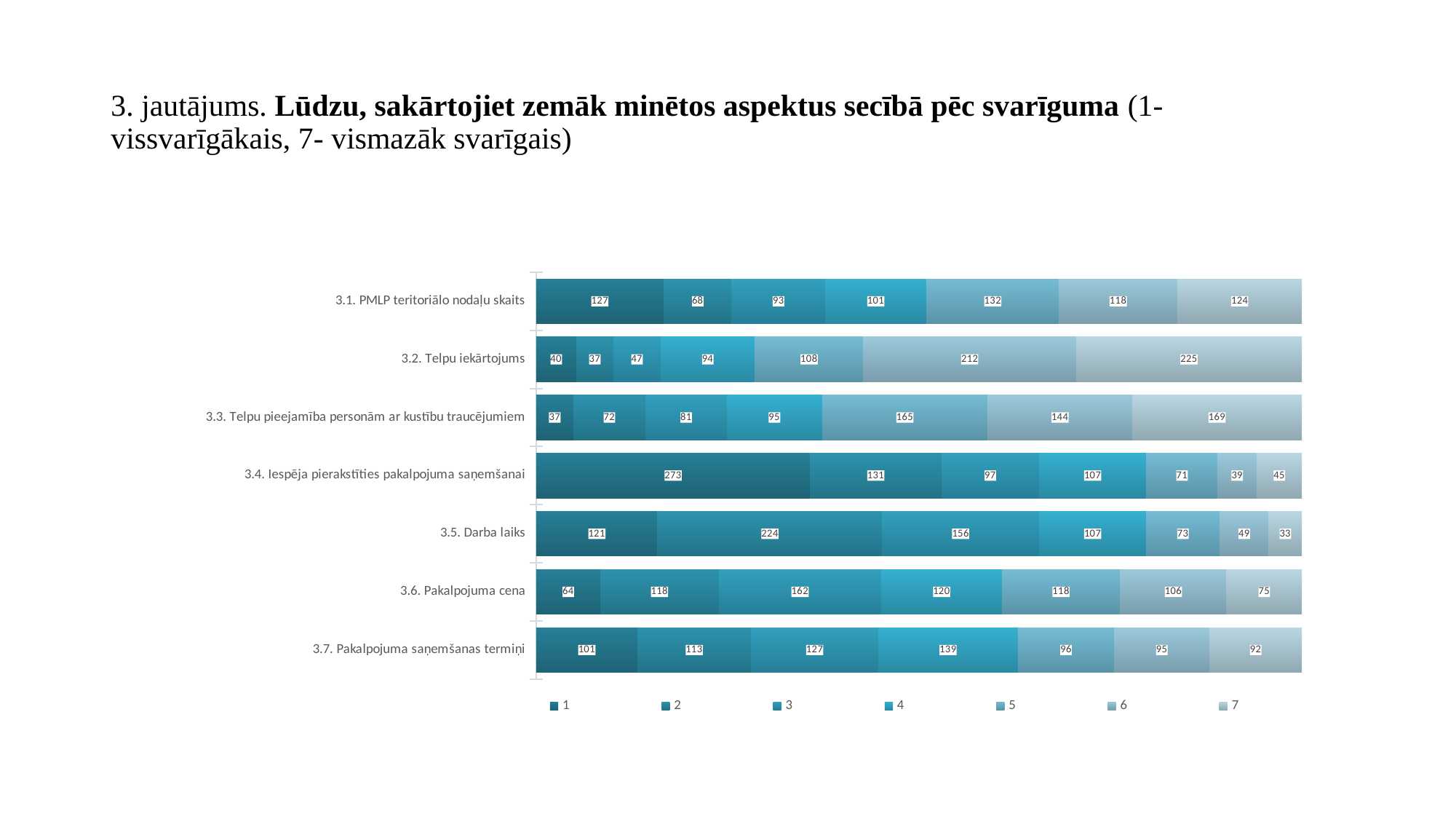
What kind of chart is shown on the slide? stacked bar chart How many categories (aspects) are plotted on the chart? 7 How many series does the legend list? 7 What is the value of series 1 for "3.4. Iespēja pierakstīties pakalpojuma saņemšanai"? 273 What is the value of series 2 for "3.5. Darba laiks"? 224 Which category has the lowest value for series 1? 3.3. Telpu pieejamība personām ar kustību traucējumiem Which is larger: the series 3 value for "3.6. Pakalpojuma cena" or the series 3 value for "3.7. Pakalpojuma saņemšanas termiņi"? 3.6. Pakalpojuma cena What is the total of the stacked bar for "3.7. Pakalpojuma saņemšanas termiņi"? 763 Which category has the highest value for series 1? 3.4. Iespēja pierakstīties pakalpojuma saņemšanai What are the legend entries of the chart? 1, 2, 3, 4, 5, 6, 7 What is the value of series 7 for "3.2. Telpu iekārtojums"? 225 What is the difference between the series 6 value for "3.2. Telpu iekārtojums" and the series 6 value for "3.1. PMLP teritoriālo nodaļu skaits"? 94